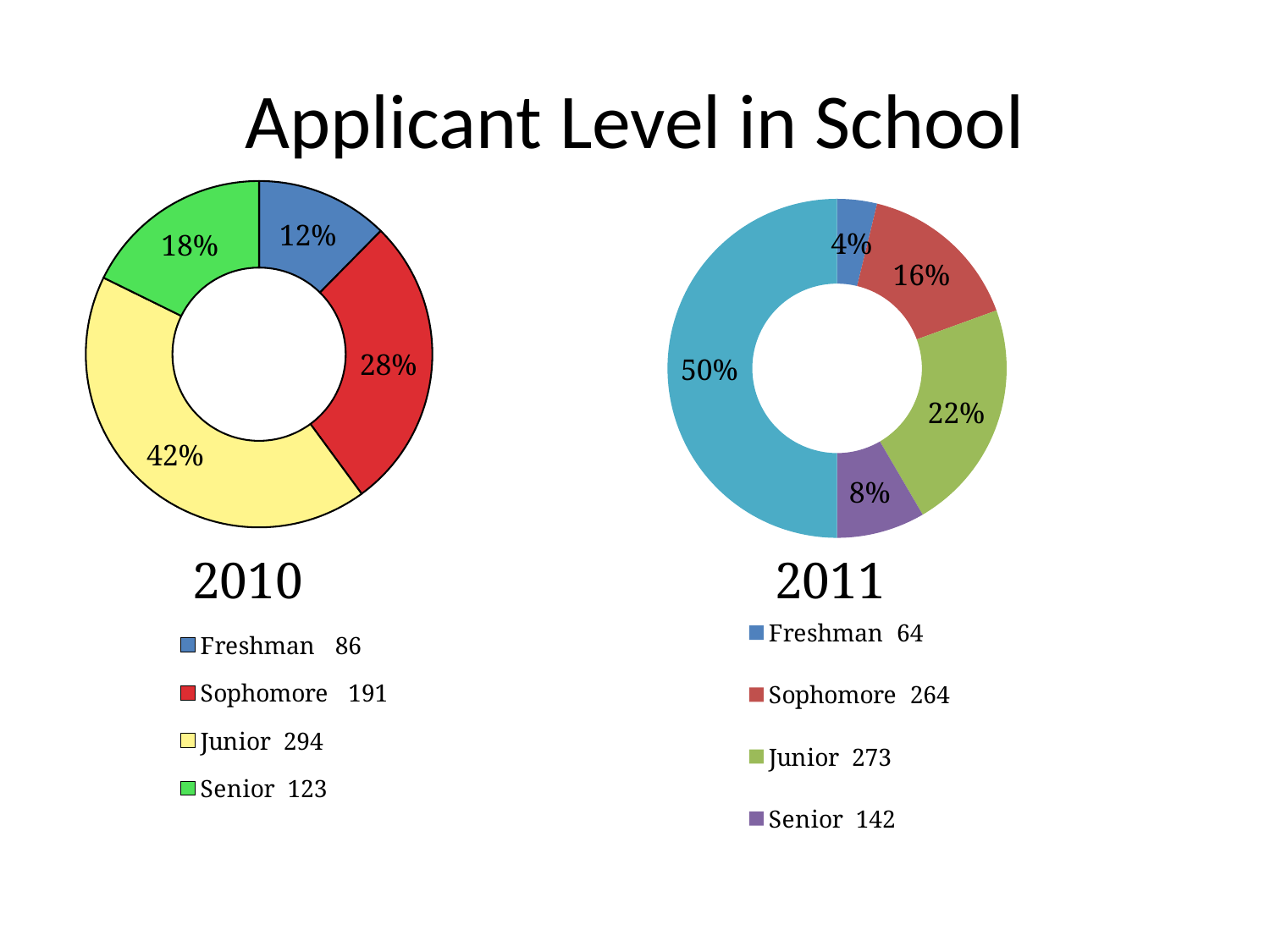
In the 2010 chart, which category has the smallest slice? Freshman In the 2011 chart, which is larger, the Sophomore count or the Junior count shown in the legend? Junior In the 2010 chart, what percentage share does the Junior slice have? 42% How many entries does the legend of the 2011 chart list? 4 In the 2011 chart, what percentage share does the Junior slice have? 22% In the 2010 chart, what is the difference between the Junior count and the Senior count shown in the legend? 171 In the 2010 chart, what is the count shown in the legend for Sophomore? 191 What type of chart is the 2010 chart? Doughnut chart In the 2010 chart, which category has the largest slice? Junior In the 2010 chart, what percentage share does the Freshman slice have? 12% In the 2011 chart, what is the count shown in the legend for Senior? 142